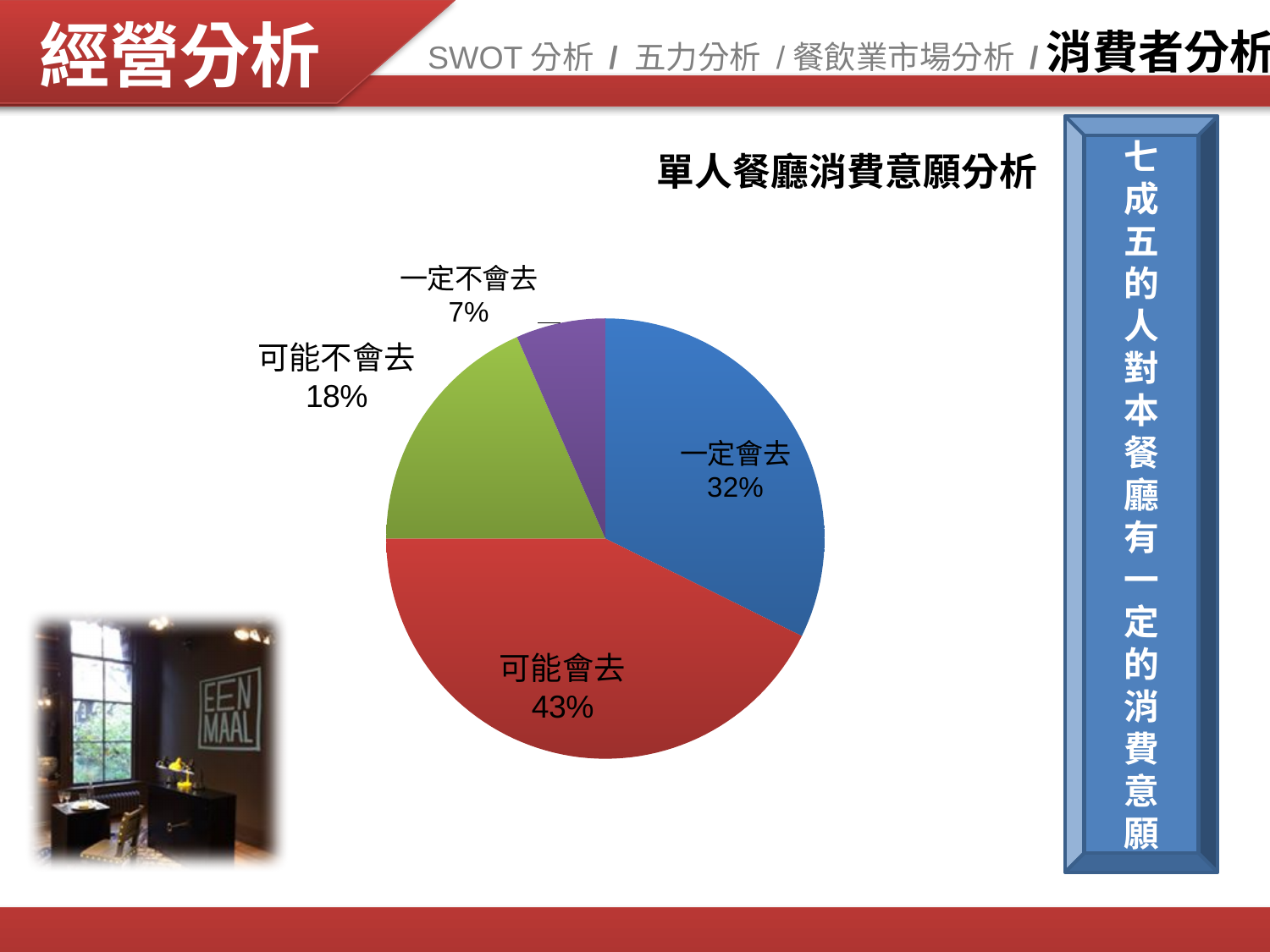
What percentage of respondents answered 一定不會去? 7% What type of chart is shown on the slide? pie chart How many categories are shown in the pie chart? 4 What percentage of respondents answered 可能不會去? 18% What is the title of the chart? 單人餐廳消費意願分析 What percentage of respondents answered 一定會去? 32% What is the difference in percentage points between 可能會去 and 一定會去? 11 What percentage of respondents answered 可能會去? 43% Which is larger, the share for 可能不會去 or the share for 一定不會去? 可能不會去 Which category has the smallest share of the pie? 一定不會去 What colour is the slice for 可能會去? red Which category has the largest share of the pie? 可能會去